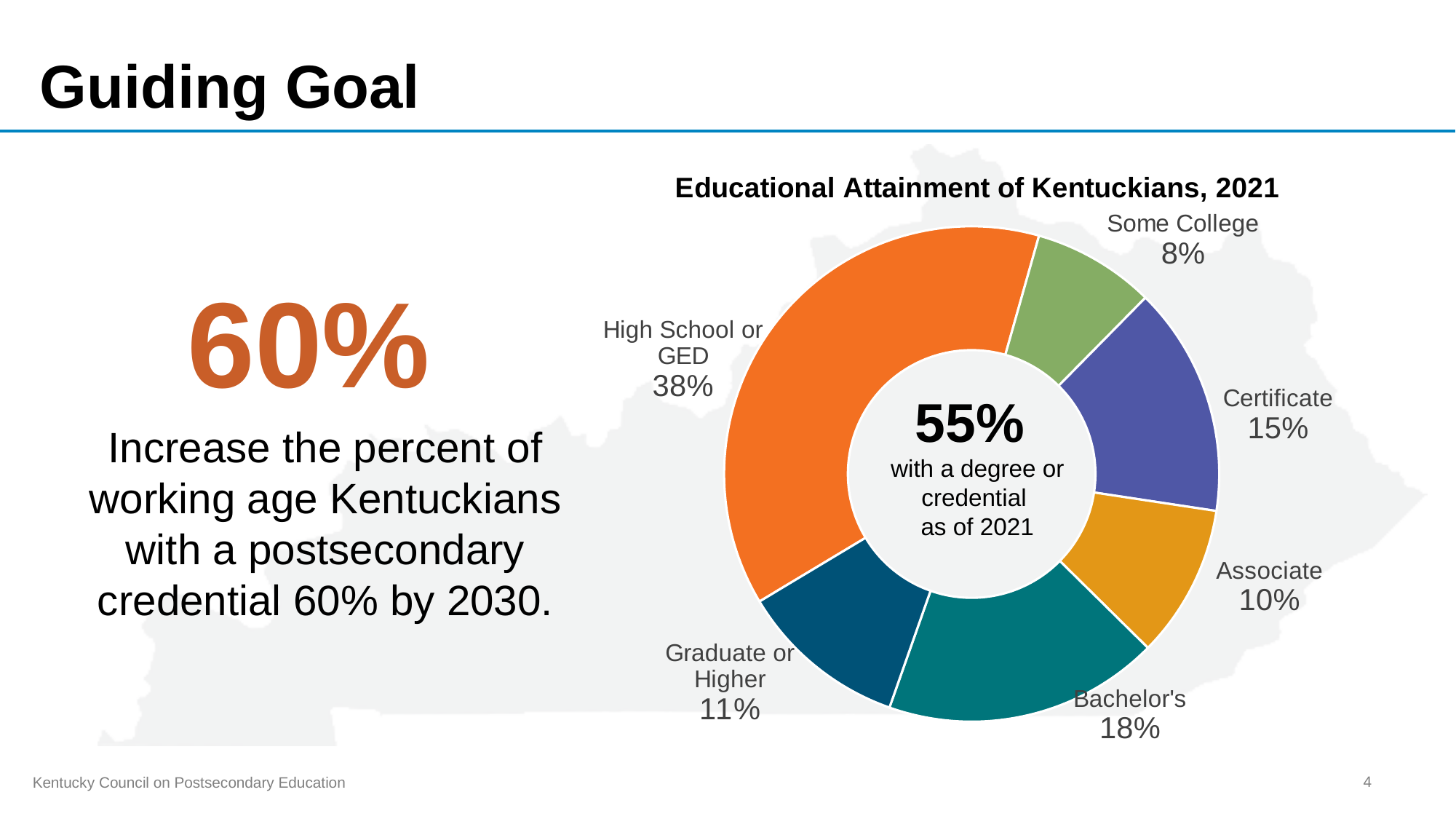
Which category has the largest share in the chart? High School or GED What is the title of the chart? Educational Attainment of Kentuckians, 2021 What is the value for Some College? 8% What kind of chart is shown on the slide? Pie chart (doughnut) What percentage of Kentuckians have a High School or GED as their highest attainment? 38% What is the value for Certificate? 15% What is the difference between the Bachelor's share and the Graduate or Higher share? 7% Which is larger, the Certificate share or the Associate share? Certificate What percentage is shown in the center of the doughnut chart? 55% What is the value for Bachelor's in the chart? 18% How many categories are shown in the chart? 6 Which category has the smallest share in the chart? Some College